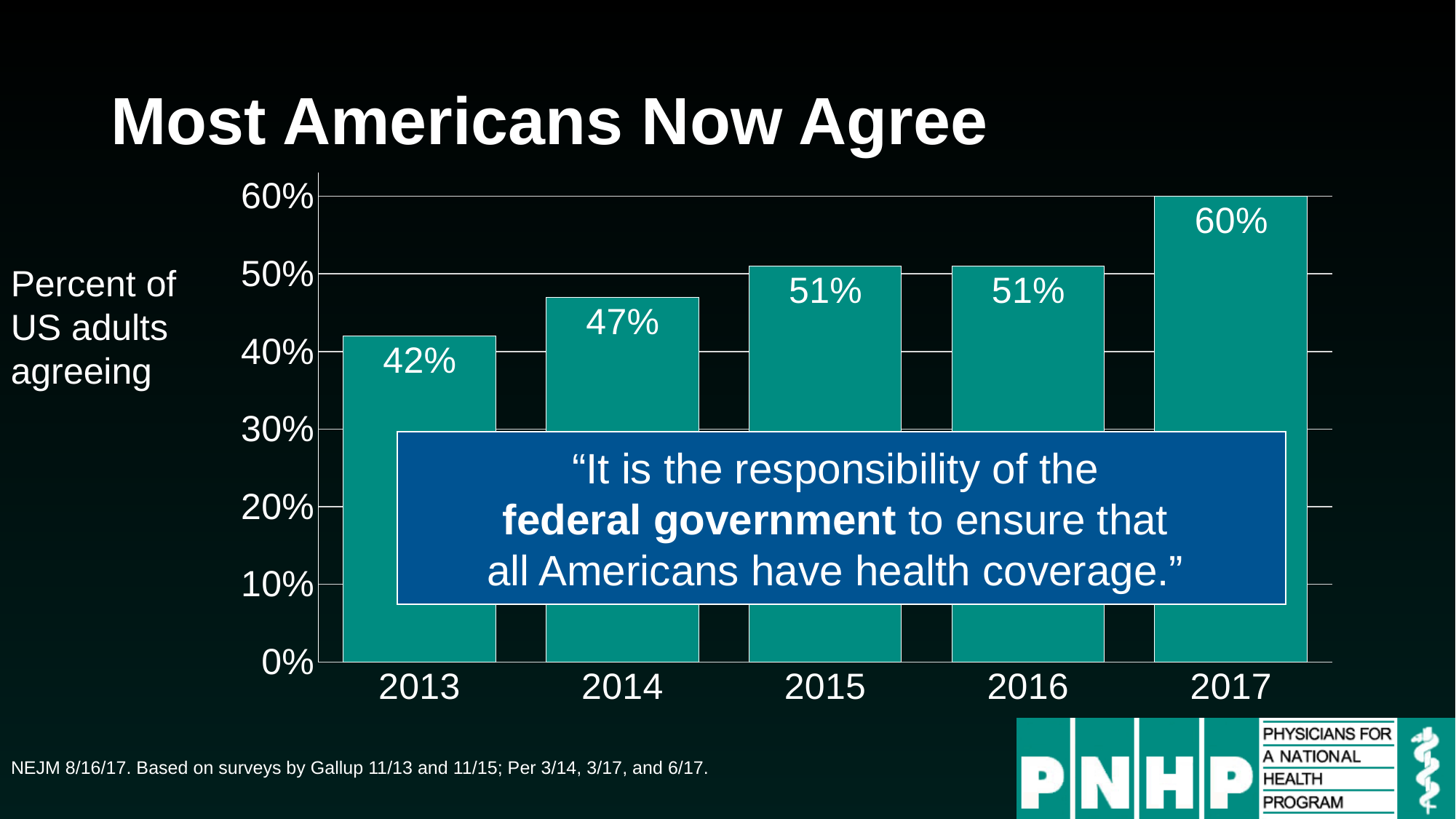
What value is shown for 2014? 47% What kind of chart is shown on the slide? bar chart Do the values generally rise or fall from 2013 to 2017? rise What percent of US adults agreed in 2017? 60% What is the difference between the 2015 value and the 2014 value? 4% What percent of US adults agreed in 2013? 42% What is the difference between the 2017 value and the 2013 value? 18% Is the value for 2013 greater or less than 40%? greater How many years are shown on the x axis? 5 Which year has the lowest percent of US adults agreeing? 2013 Which year has the highest percent of US adults agreeing? 2017 Which is larger, the value for 2014 or the value for 2016? 2016